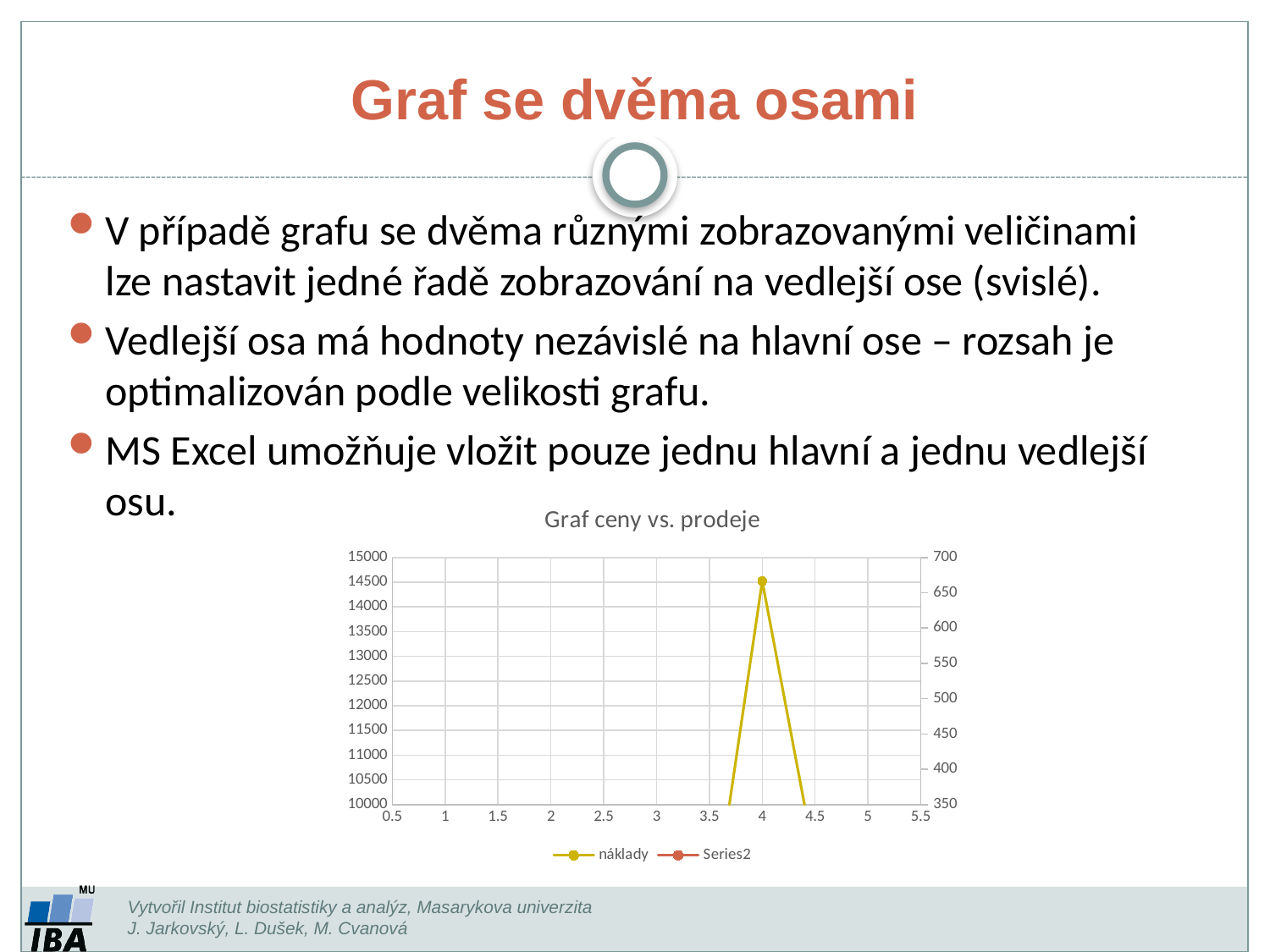
What are the names of the series listed in the chart legend? náklady, Series2 How many data point markers are visible on the plotted line? 1 What kind of chart is shown on the slide? line chart What is the maximum value shown on the right (secondary) vertical axis? 700 How many series does the chart legend list? 2 What is the minimum value shown on the right (secondary) vertical axis? 350 At which x value does the náklady series reach its peak? 4 Is the value of the náklady series at x = 4 greater or less than 14000 on the left axis? greater